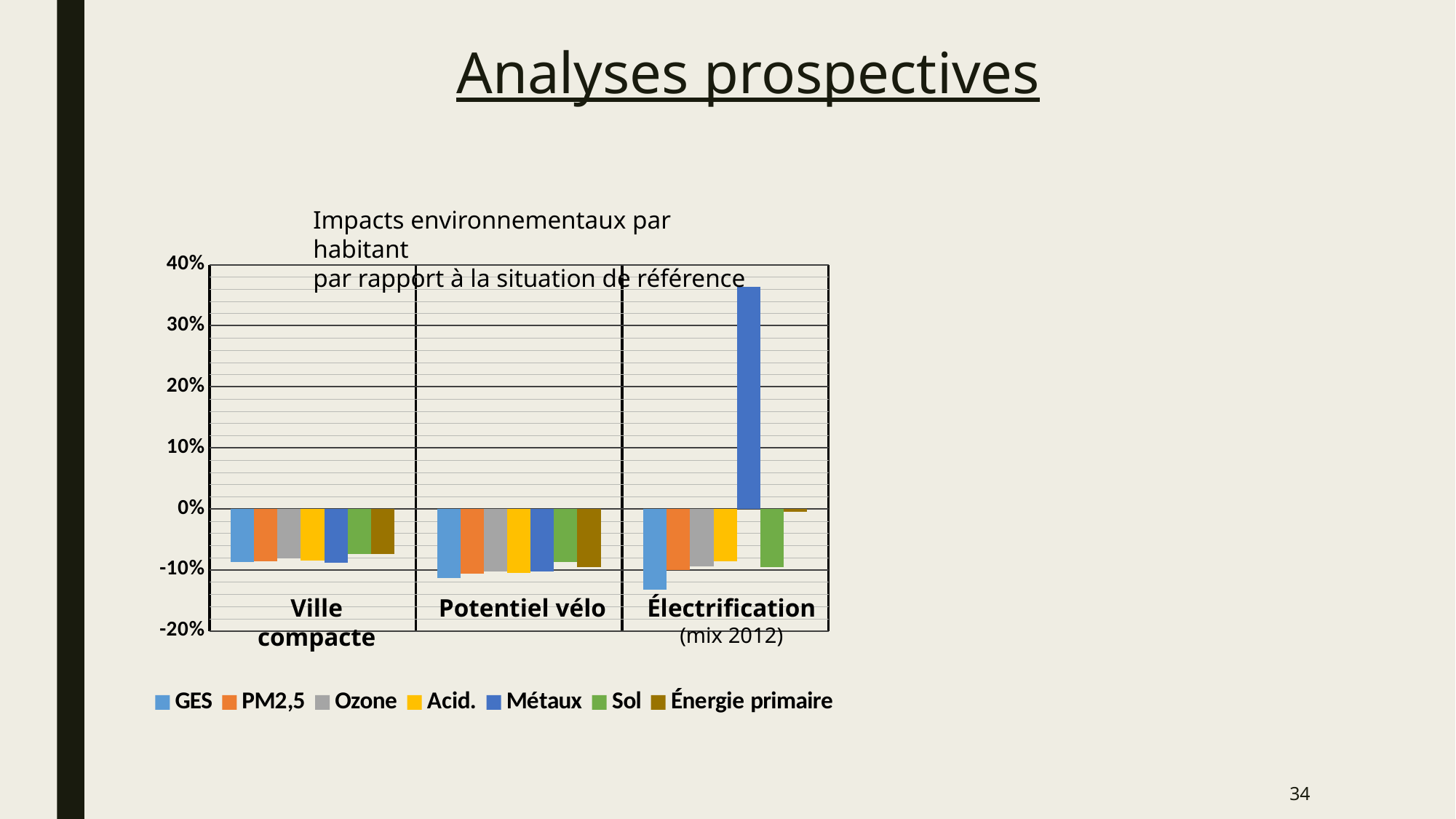
What kind of chart is shown on the slide? Bar chart Is the value for GES in the Ville compacte category greater or less than -10%? greater Which series is the only one with a positive value in the chart? Métaux Which is larger: the Métaux value for Électrification (mix 2012) or the Métaux value for Ville compacte? Électrification (mix 2012) Which is larger: the GES value for Ville compacte or the GES value for Électrification (mix 2012)? Ville compacte Is the value for GES in the Potentiel vélo category greater or less than -10%? less Which series has the highest value in the Électrification (mix 2012) category? Métaux Which series has the lowest value in the Électrification (mix 2012) category? GES How many series does the chart legend list? 7 Is the value for Métaux in the Électrification (mix 2012) category greater or less than 30%? greater How many categories are shown on the x axis of the chart? 3 What is the first line of the chart's title? Impacts environnementaux par